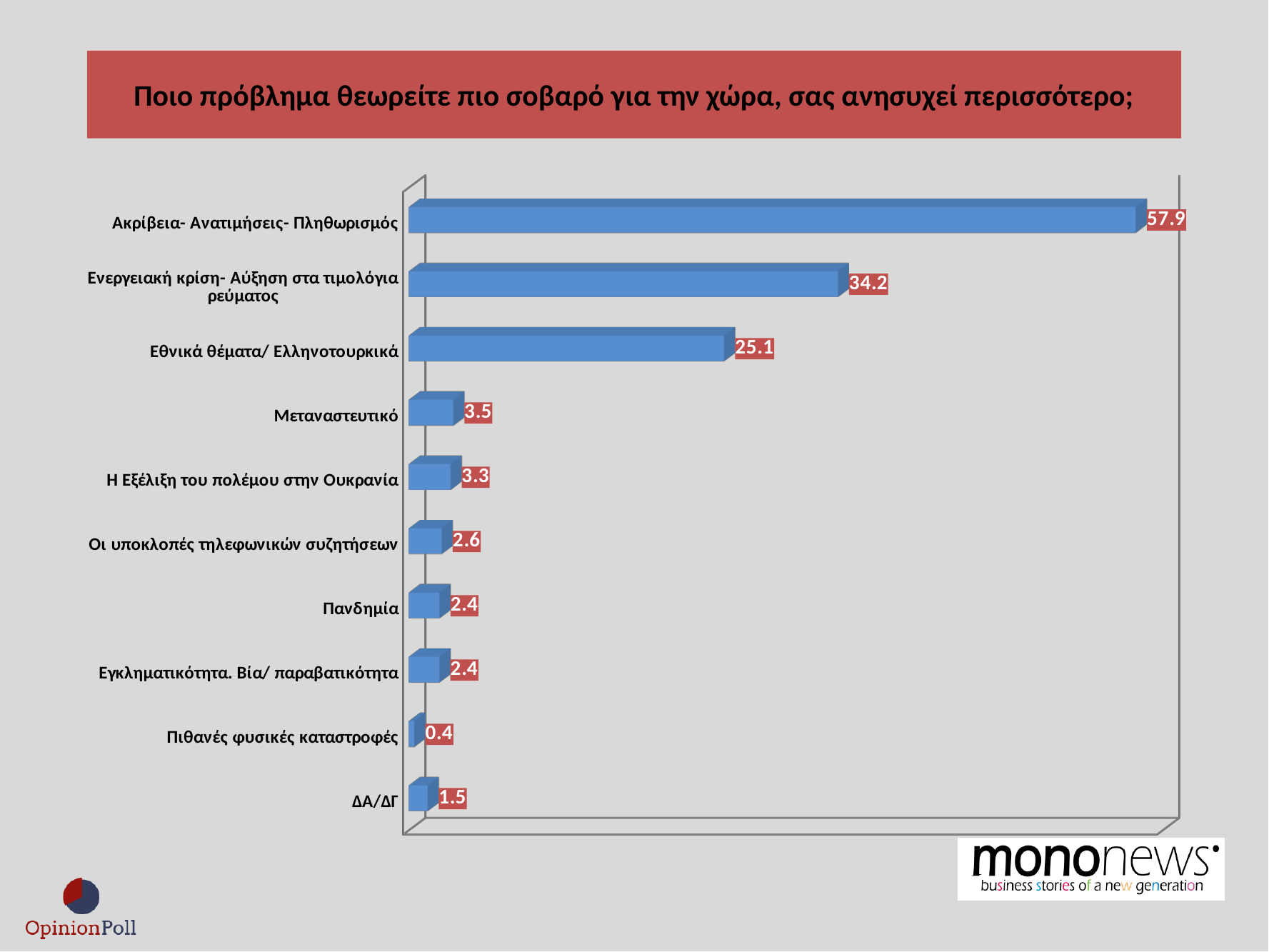
Which is larger, the value for Μεταναστευτικό or the value for Οι υποκλοπές τηλεφωνικών συζητήσεων? Μεταναστευτικό What is the value for Η Εξέλιξη του πολέμου στην Ουκρανία? 3.3 What is the difference between the values for Ακρίβεια- Ανατιμήσεις- Πληθωρισμός and Ενεργειακή κρίση- Αύξηση στα τιμολόγια ρεύματος? 23.7 Which category has the highest value? Ακρίβεια- Ανατιμήσεις- Πληθωρισμός What kind of chart is shown on the slide? Bar chart What is the value for ΔΑ/ΔΓ? 1.5 What is the title of the chart? Ποιο πρόβλημα θεωρείτε πιο σοβαρό για την χώρα, σας ανησυχεί περισσότερο; How many categories are shown in the chart? 10 What is the value for Ενεργειακή κρίση- Αύξηση στα τιμολόγια ρεύματος? 34.2 What is the value for Ακρίβεια- Ανατιμήσεις- Πληθωρισμός? 57.9 What is the value for Εθνικά θέματα/ Ελληνοτουρκικά? 25.1 Which category has the lowest value? Πιθανές φυσικές καταστροφές